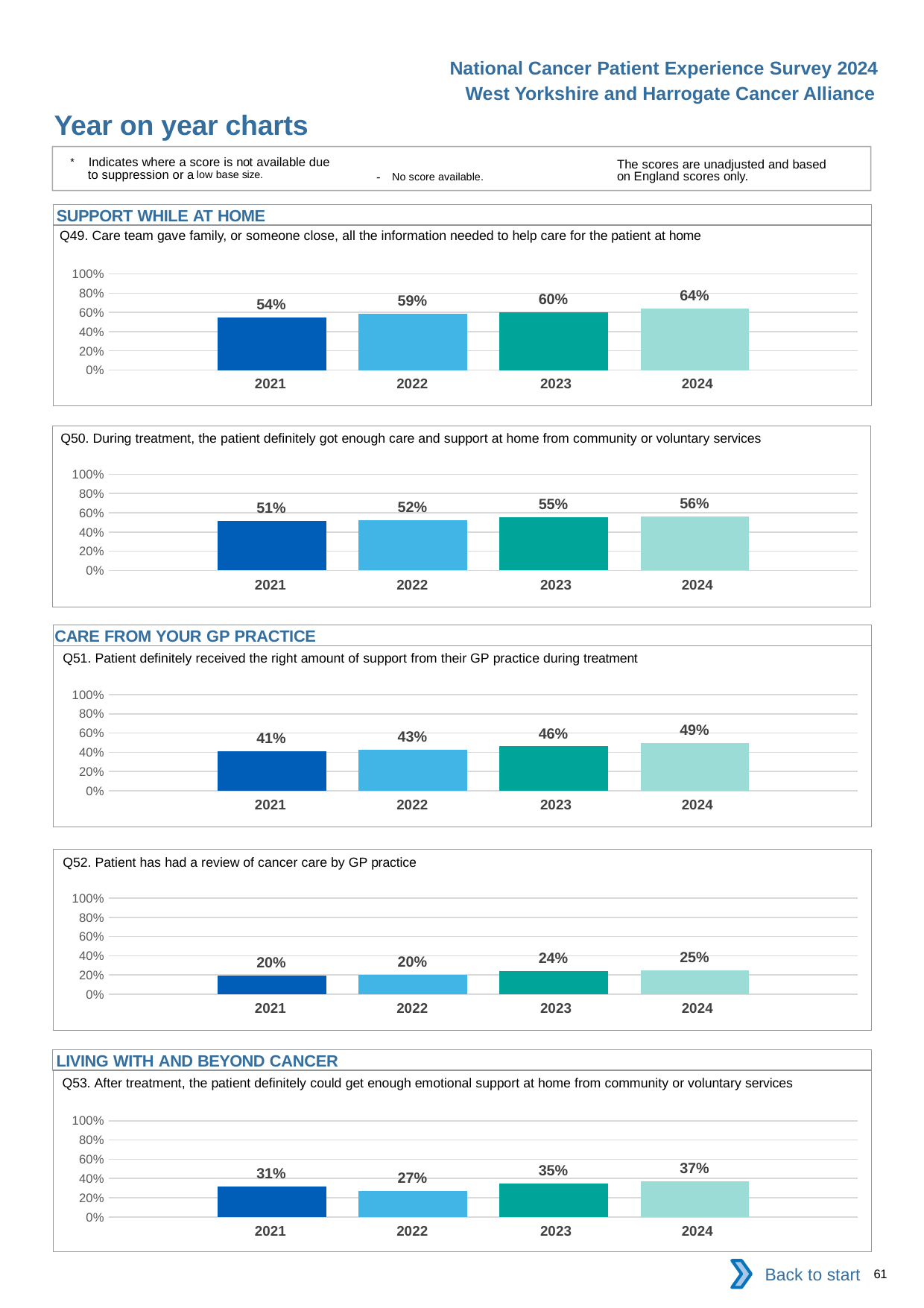
In the Q50 chart, what is the difference between the 2024 and 2021 values? 5% In the Q50 chart, what is the value for 2023? 55% In the Q49 chart, which year has the lowest value? 2021 In the Q52 chart, what is the difference between the 2023 and 2022 values? 4% In the Q53 chart, what is the value for 2024? 37% How many years are shown on the x axis of the Q49 chart? 4 In the Q51 chart, which year has the highest value? 2024 In the Q53 chart, which is larger, the value for 2021 or the value for 2022? 2021 In the Q51 chart, what is the value for 2021? 41% In the Q52 chart, is the value for 2024 greater or less than 40%? less What type of chart is used for Q52? Bar chart In the Q49 chart, what is the value for 2024? 64%